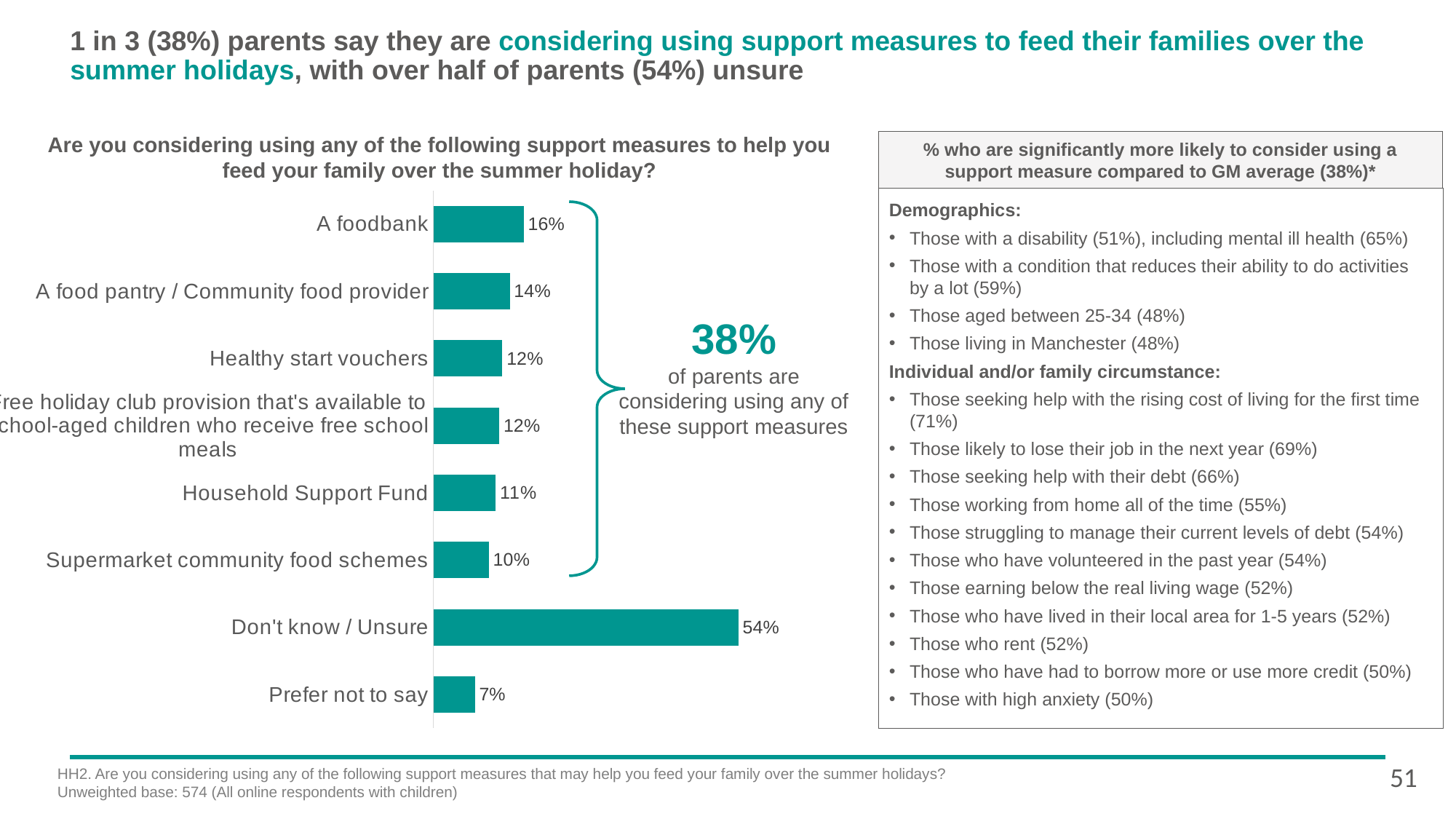
Which category has the highest value in the chart? Don't know / Unsure What is the value for Prefer not to say? 7% What is the value for Don't know / Unsure? 54% Which category has the lowest value in the chart? Prefer not to say What kind of chart is shown on the slide? Bar chart How many categories are shown in the bar chart? 8 Which is larger: the value for A food pantry / Community food provider or the value for Healthy start vouchers? A food pantry / Community food provider What percentage of parents are considering using a foodbank? 16% What is the value for Household Support Fund? 11% What is the difference between the values for Don't know / Unsure and A foodbank? 38% What is the difference between the values for A foodbank and Supermarket community food schemes? 6% What percentage of parents are considering using any of the support measures, according to the callout next to the chart? 38%